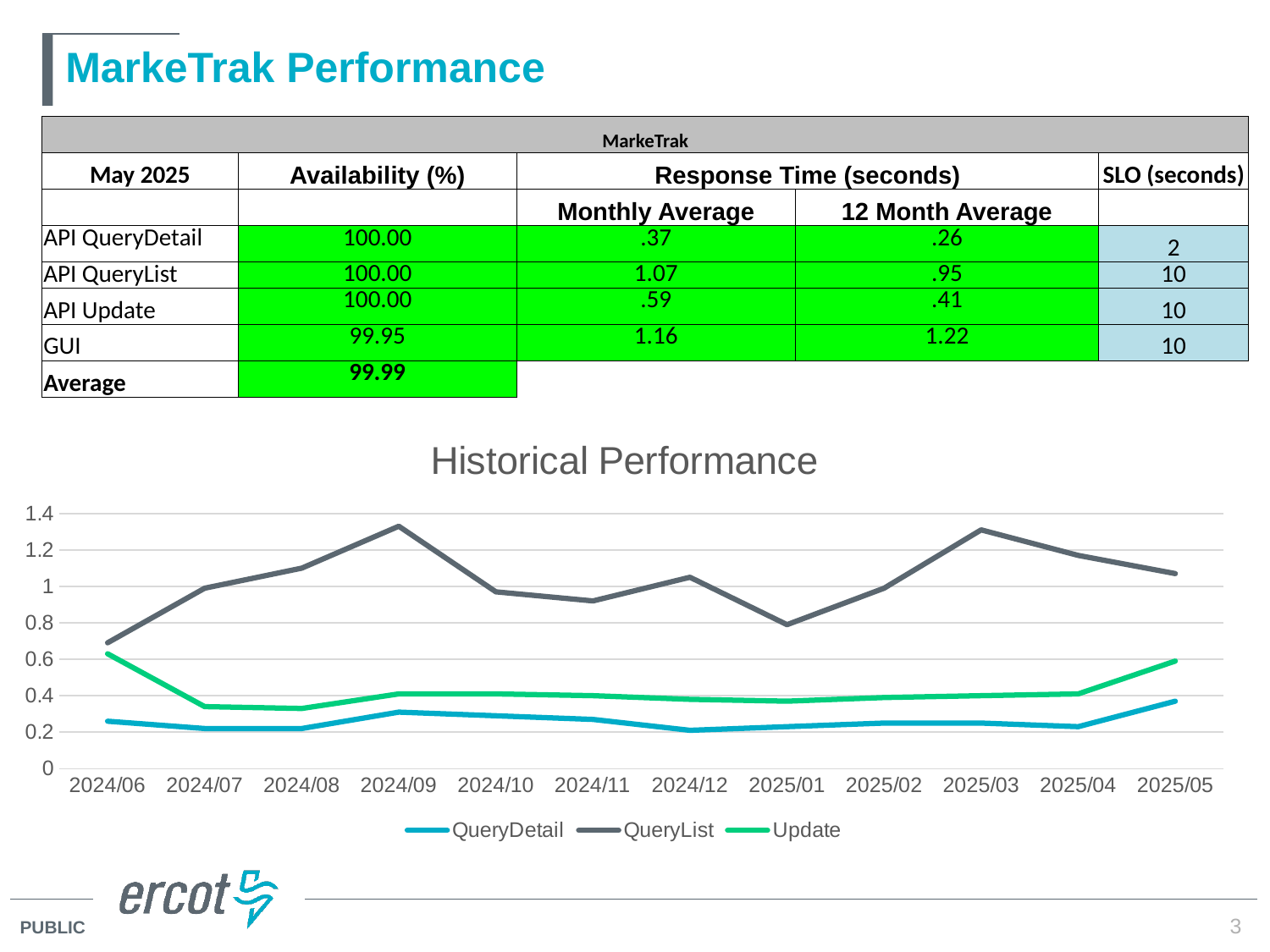
In the "Historical Performance" chart, which series has the lowest values across the whole period? QueryDetail In the "Historical Performance" chart, which series has the highest values across the whole period? QueryList In the "Historical Performance" chart, is the QueryList value for 2025/03 greater or less than 1.2? greater In the "Historical Performance" chart, at which month is the QueryList series at its lowest? 2024/06 In the "Historical Performance" chart, is the QueryList value for 2024/06 greater or less than 0.8? less In the "Historical Performance" chart, does the QueryList series rise or fall from 2024/06 to 2024/09? rise What is the title of the line chart on the slide? Historical Performance In the "Historical Performance" chart, is the QueryDetail value for 2024/12 greater or less than 0.4? less How many months are plotted along the x axis of the "Historical Performance" chart? 12 What kind of chart is the "Historical Performance" chart? line chart How many series does the legend of the "Historical Performance" chart list? 3